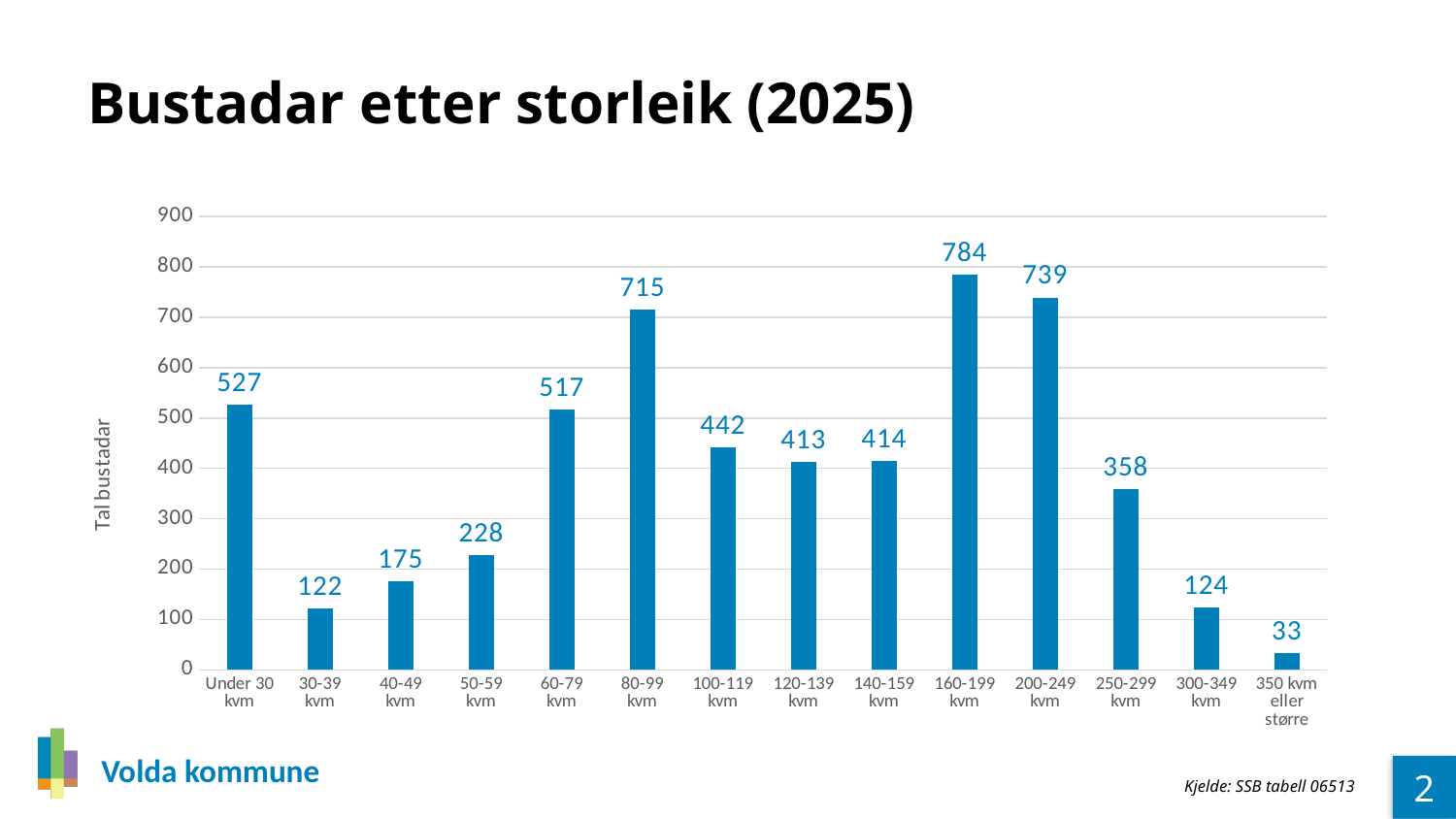
What is the difference between the values for 160-199 kvm and 200-249 kvm? 45 What is the value for 350 kvm eller større? 33 What is the label of the y axis? Tal bustadar What is the value for 80-99 kvm? 715 Which category has the highest value? 160-199 kvm What is the title of the chart? Bustadar etter storleik (2025) What kind of chart is this? bar chart What is the value for Under 30 kvm? 527 How many categories are shown on the x axis? 14 What is the difference between the values for 50-59 kvm and 40-49 kvm? 53 Which category has the lowest value? 350 kvm eller større Which is larger, the value for 60-79 kvm or the value for 100-119 kvm? 60-79 kvm